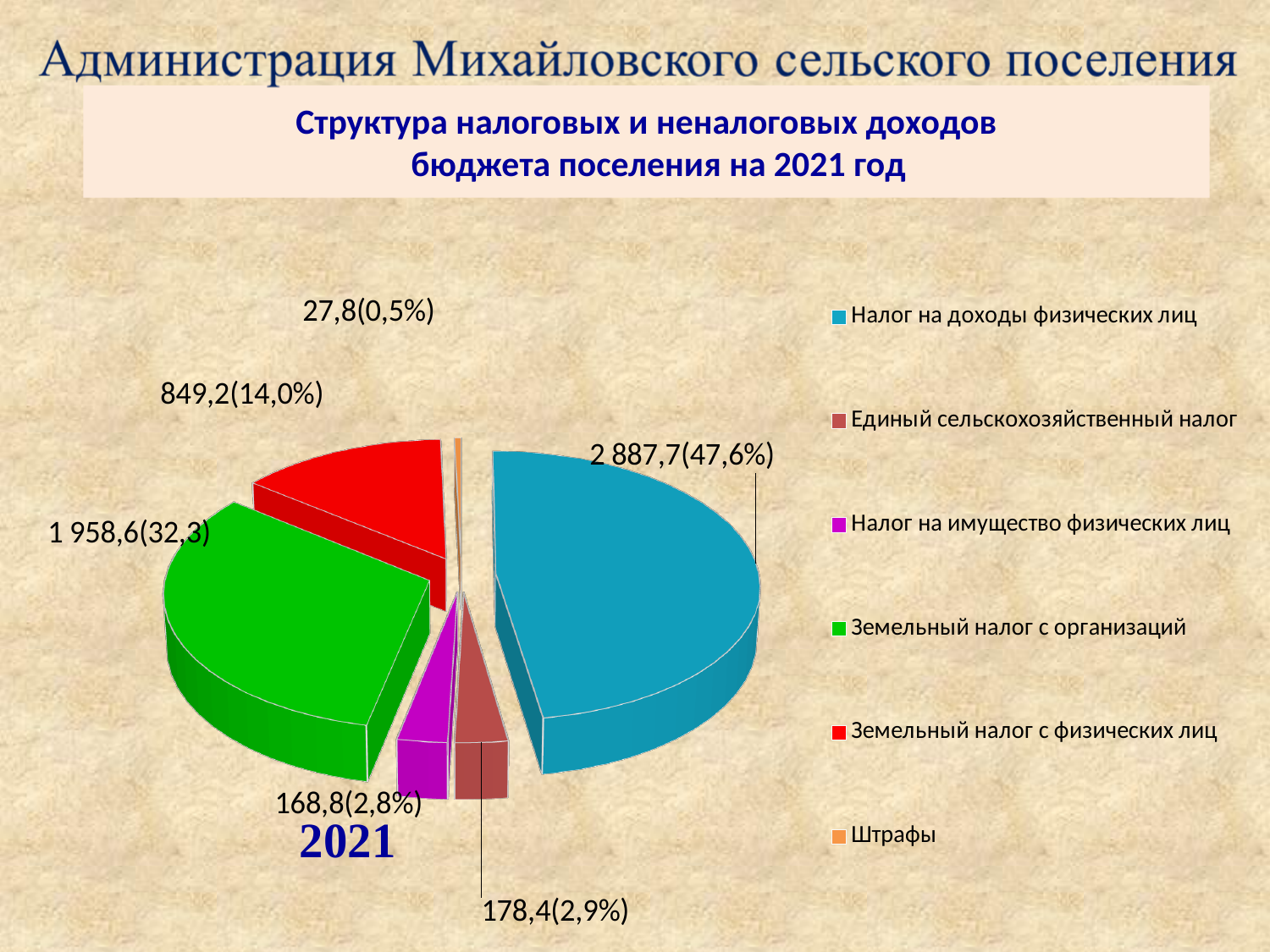
What value is shown for Земельный налог с организаций? 1 958,6(32,3) Which category has the largest share of the pie? Налог на доходы физических лиц What share of the pie does Земельный налог с физических лиц have? 14,0% What type of chart is shown on the slide? Pie chart Which category has the smallest share of the pie? Штрафы What value is shown for Единый сельскохозяйственный налог? 178,4(2,9%) What colour is the slice for Земельный налог с организаций? Green How many entries does the legend list? 6 Which is larger: Налог на имущество физических лиц or Земельный налог с физических лиц? Земельный налог с физических лиц What value is shown for Штрафы? 27,8(0,5%) What value is shown for Налог на доходы физических лиц? 2 887,7(47,6%) How many slices does the pie chart have? 6